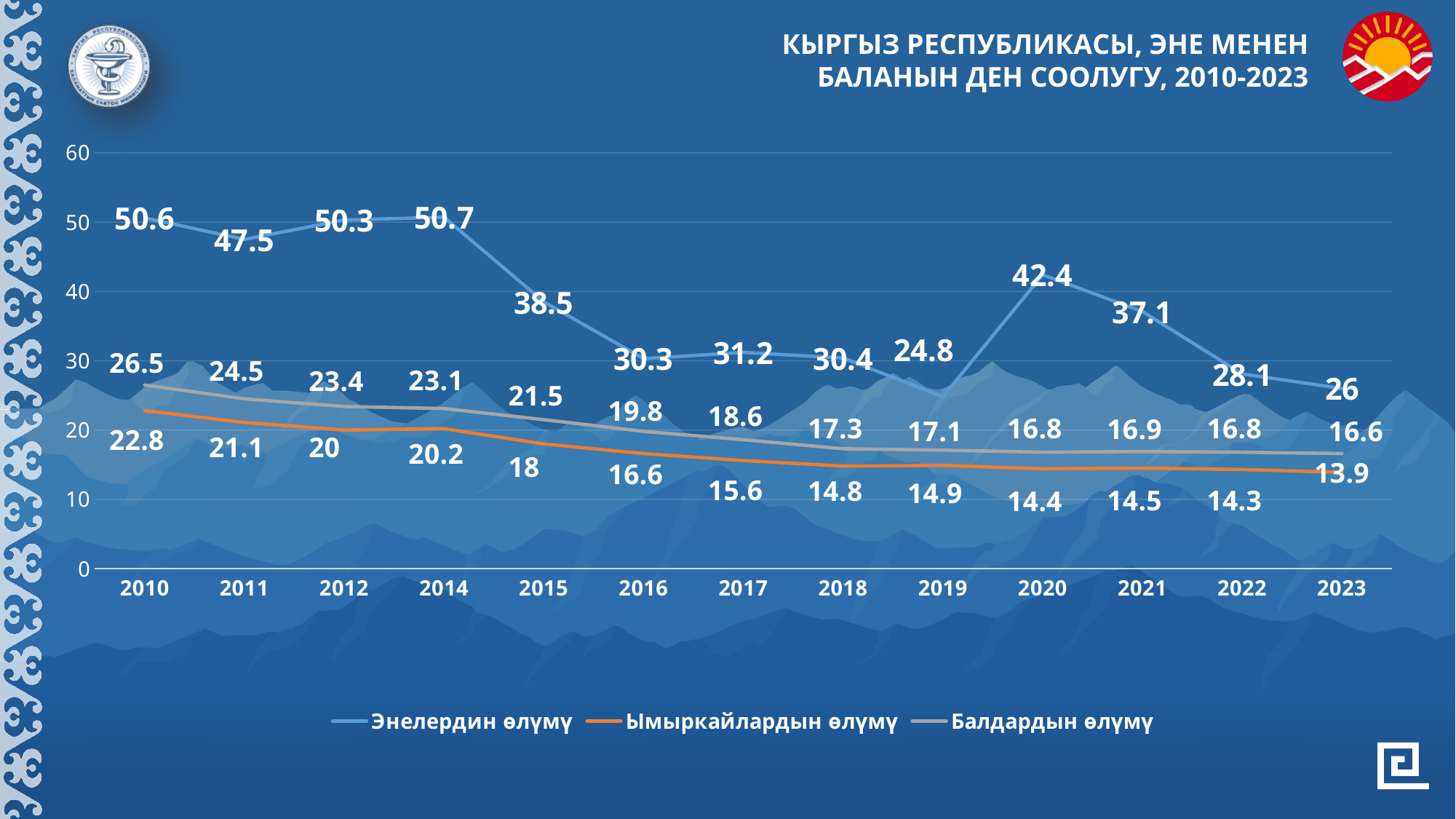
In which year is Ымыркайлардын өлүмү at its lowest? 2023 Which is larger in 2020: Энелердин өлүмү or Балдардын өлүмү? Энелердин өлүмү What type of chart is shown on the slide? line chart How many years are plotted along the x axis? 13 How many series does the legend list? 3 In which year is Энелердин өлүмү at its highest? 2014 What is the value of Ымыркайлардын өлүмү in 2015? 18 In which year is Энелердин өлүмү at its lowest? 2019 What is the difference between the Энелердин өлүмү values for 2010 and 2023? 24.6 What is the value of Энелердин өлүмү in 2014? 50.7 Does Балдардын өлүмү generally rise or fall from 2010 to 2023? fall What is the value of Балдардын өлүмү in 2018? 17.3